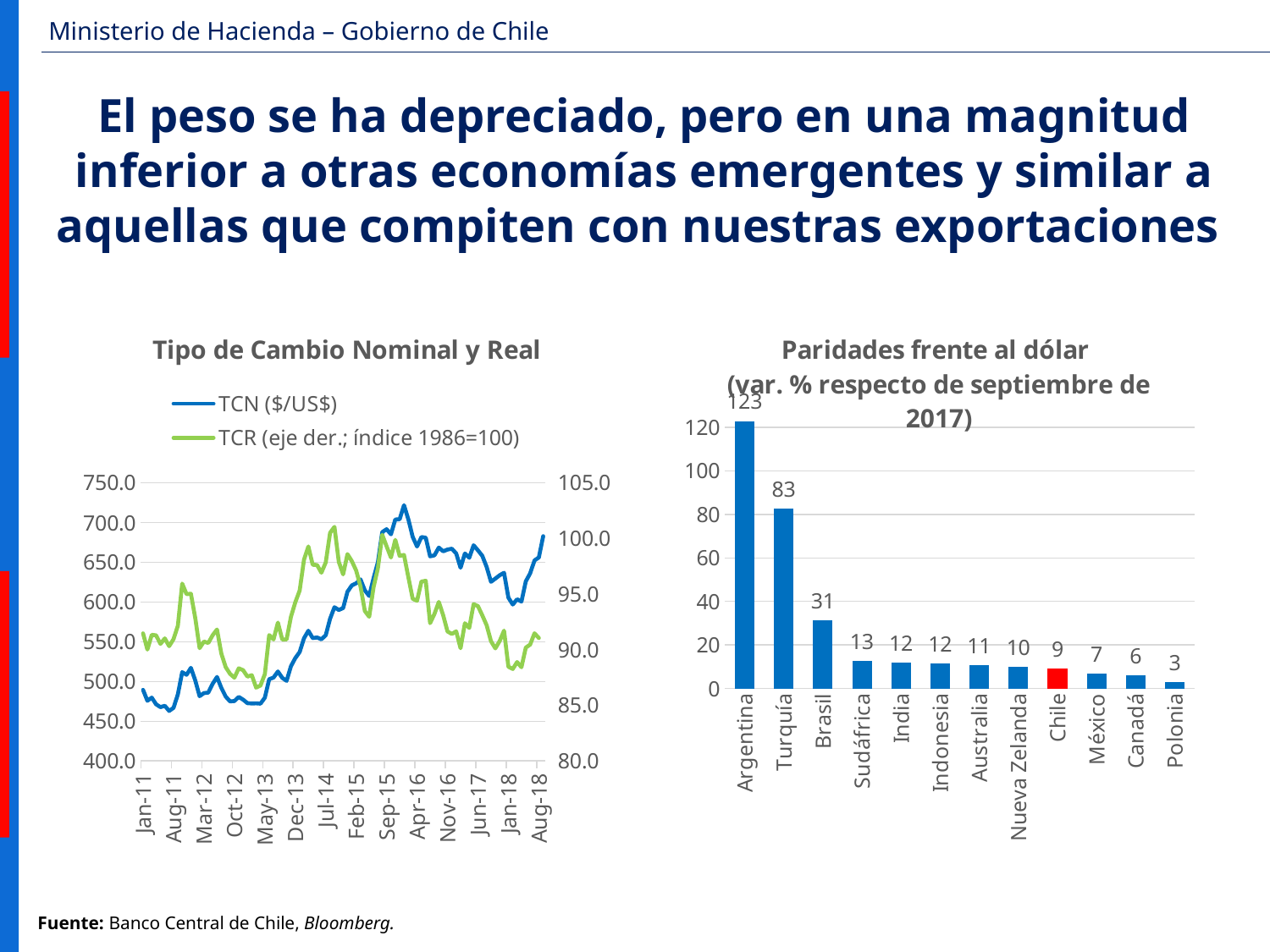
In the 'Paridades frente al dólar' chart, what is the value for Argentina? 123 How many countries are shown in the 'Paridades frente al dólar' chart? 12 In the 'Tipo de Cambio Nominal y Real' chart, is the TCN ($/US$) value at Jan-11 greater or less than 500.0? less How many series does the legend of the 'Tipo de Cambio Nominal y Real' chart list? 2 What kind of chart is 'Tipo de Cambio Nominal y Real'? Line chart In the 'Paridades frente al dólar' chart, what is the value for Chile? 9 In the 'Paridades frente al dólar' chart, what is the difference between the values for Turquía and Brasil? 52 In the 'Paridades frente al dólar' chart, which is larger, the value for Sudáfrica or the value for México? Sudáfrica In the 'Paridades frente al dólar' chart, which country has the lowest value? Polonia In the 'Paridades frente al dólar' chart, which country has the highest value? Argentina In the 'Paridades frente al dólar' chart, which country's bar is coloured red? Chile What kind of chart is 'Paridades frente al dólar'? Bar chart